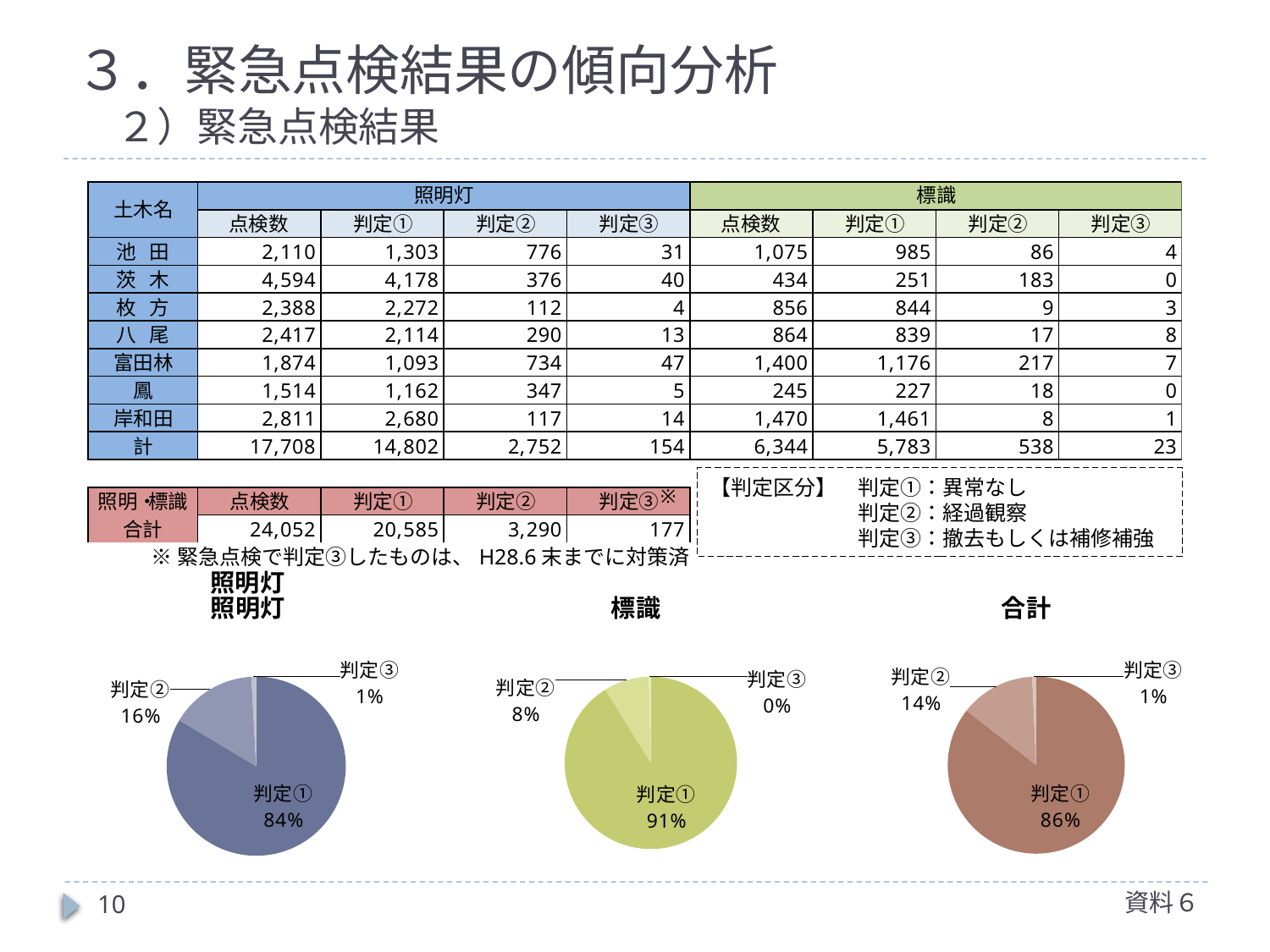
In the 合計 pie chart, what share does 判定② have? 14% In the 合計 pie chart, what is the difference in percentage points between 判定① and 判定②? 72 In the 標識 pie chart, what share does 判定① have? 91% In the 照明灯 pie chart, what share does 判定① have? 84% How many slices does the 合計 pie chart have? 3 In the 照明灯 pie chart, which category has the largest slice? 判定① In the 標識 pie chart, which category has the smallest slice? 判定③ What kind of chart is the 標識 chart? pie chart Which is larger: the 判定② share in the 照明灯 pie chart or the 判定② share in the 標識 pie chart? 照明灯